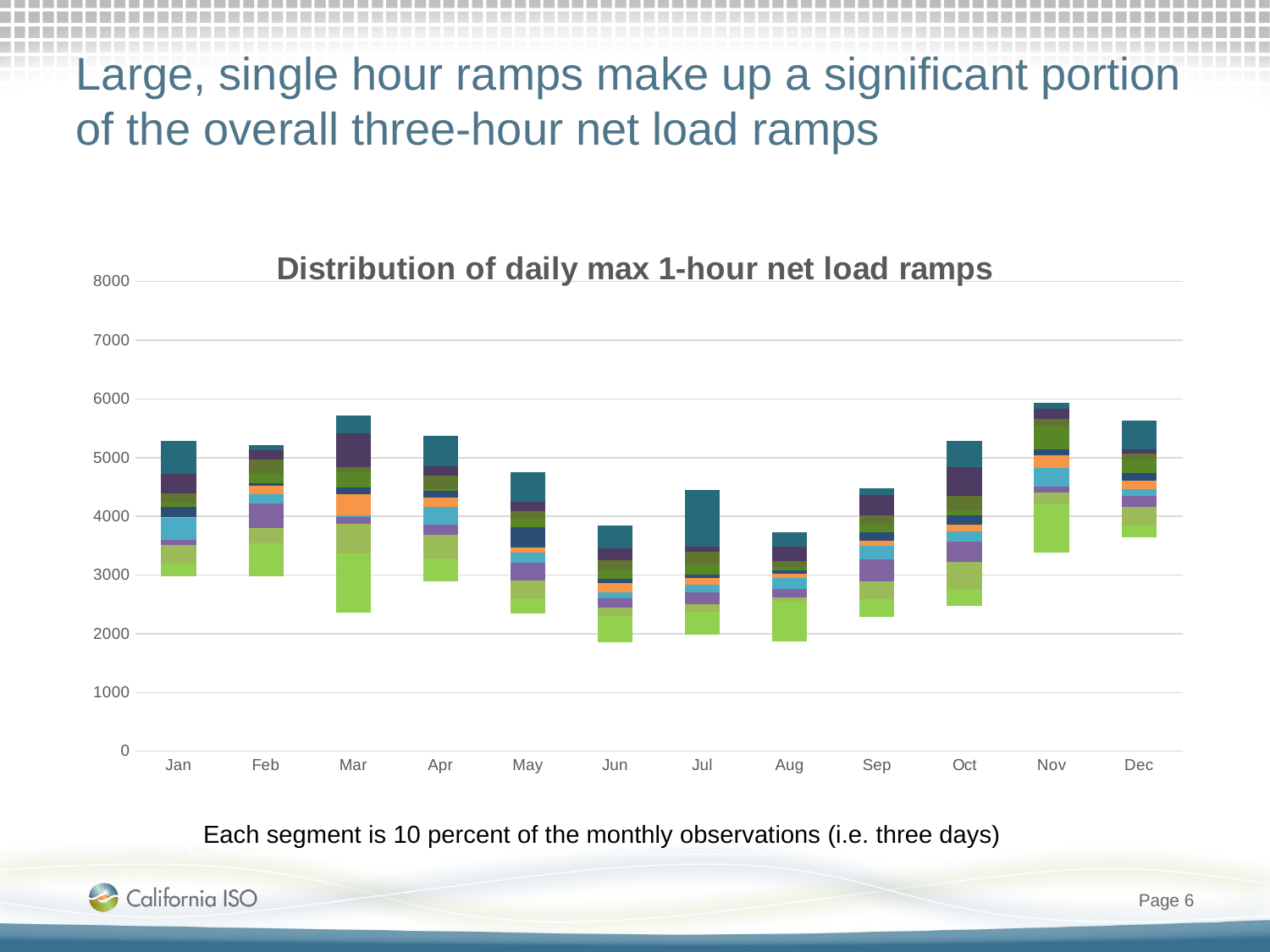
Is the top of the Jul bar greater or less than 4000? greater Which month's bar reaches the highest value on the chart? Nov Is the top of the May bar greater or less than 5000? less Is the bottom of the Mar bar greater or less than 3000? less Which bar reaches higher, Nov or Jun? Nov What kind of chart is shown on the slide? Stacked bar chart Do the tops of the bars rise or fall from Mar to Aug? fall How many months are shown on the x axis of the chart? 12 What is the title of the chart? Distribution of daily max 1-hour net load ramps According to the note below the chart, what share of the monthly observations does each segment represent? 10 percent